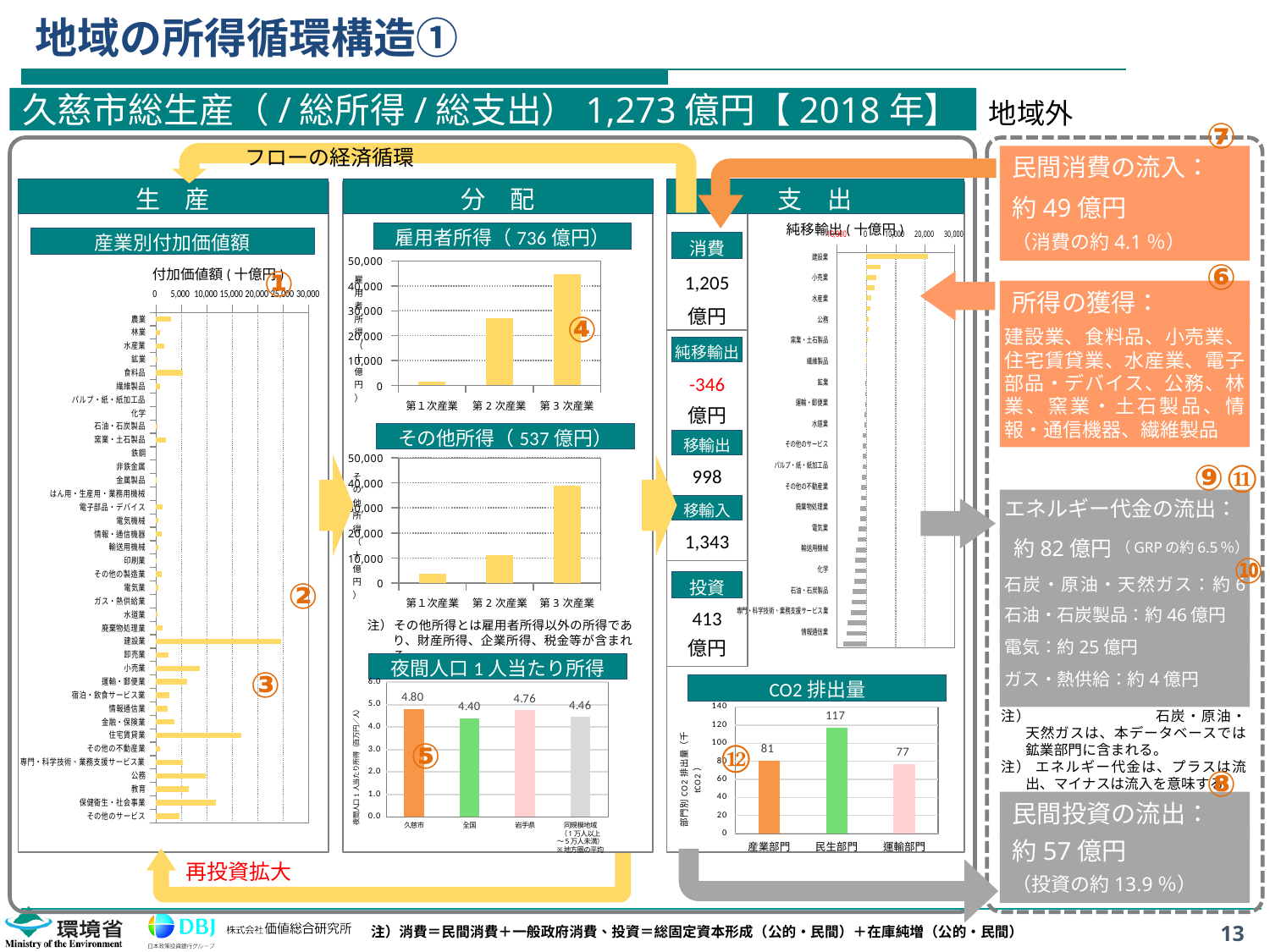
In the 夜間人口1人当たり所得 chart, which category has the highest value? 久慈市 In the CO2排出量 chart, which sector has the highest emissions? 民生部門 In the 雇用者所得 chart, is the value for 第3次産業 greater or less than 40,000? greater What kind of chart is the CO2排出量 chart? bar chart In the 夜間人口1人当たり所得 chart, what is the difference between 久慈市 and 全国? 0.40 In the その他所得 chart, is the value for 第2次産業 greater or less than 20,000? less In the CO2排出量 chart, what is the value for 民生部門? 117 In the CO2排出量 chart, which sector has the lowest emissions? 運輸部門 In the 夜間人口1人当たり所得 chart, what is the value for 久慈市? 4.80 In the CO2排出量 chart, how many sectors are plotted? 3 In the CO2排出量 chart, what is the difference between 民生部門 and 産業部門? 36 In the 産業別付加価値額 chart, which industry has the longest bar? 建設業